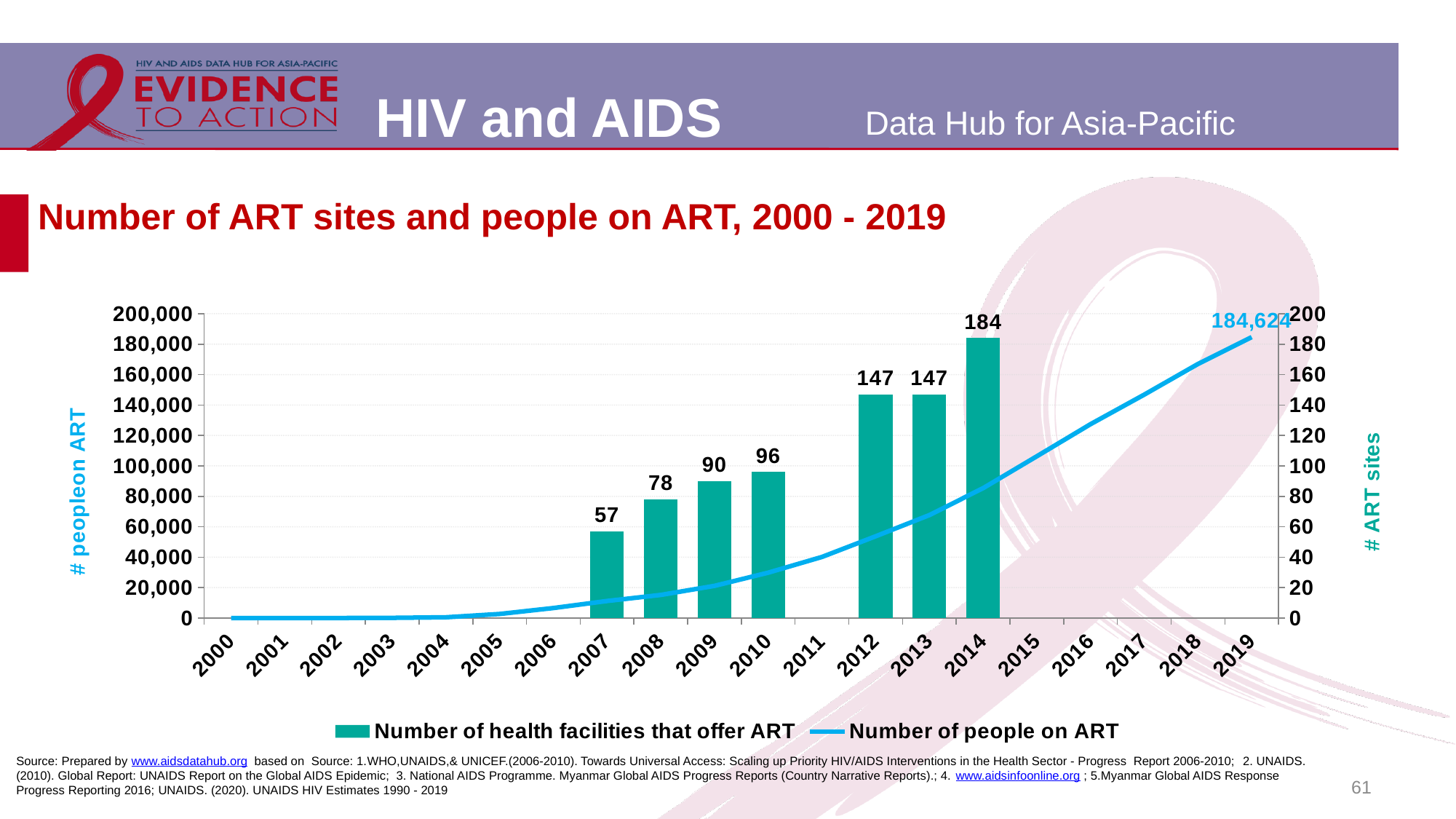
What is the number of people on ART in 2019, as labelled on the chart? 184,624 What is the number of health facilities that offer ART in 2014? 184 Among the years with a bar shown, which year has the lowest number of health facilities that offer ART? 2007 Which year has the highest number of health facilities that offer ART? 2014 What is the difference between the number of health facilities that offer ART in 2014 and in 2013? 37 Is the number of people on ART in 2010 greater or less than 40,000? less Does the number of people on ART rise or fall from 2000 to 2019? rise How many years are shown on the x axis? 20 What is the number of health facilities that offer ART in 2007? 57 Which year has more health facilities that offer ART, 2009 or 2010? 2010 Is the number of people on ART in 2015 greater or less than 100,000? greater How many series does the legend list? 2